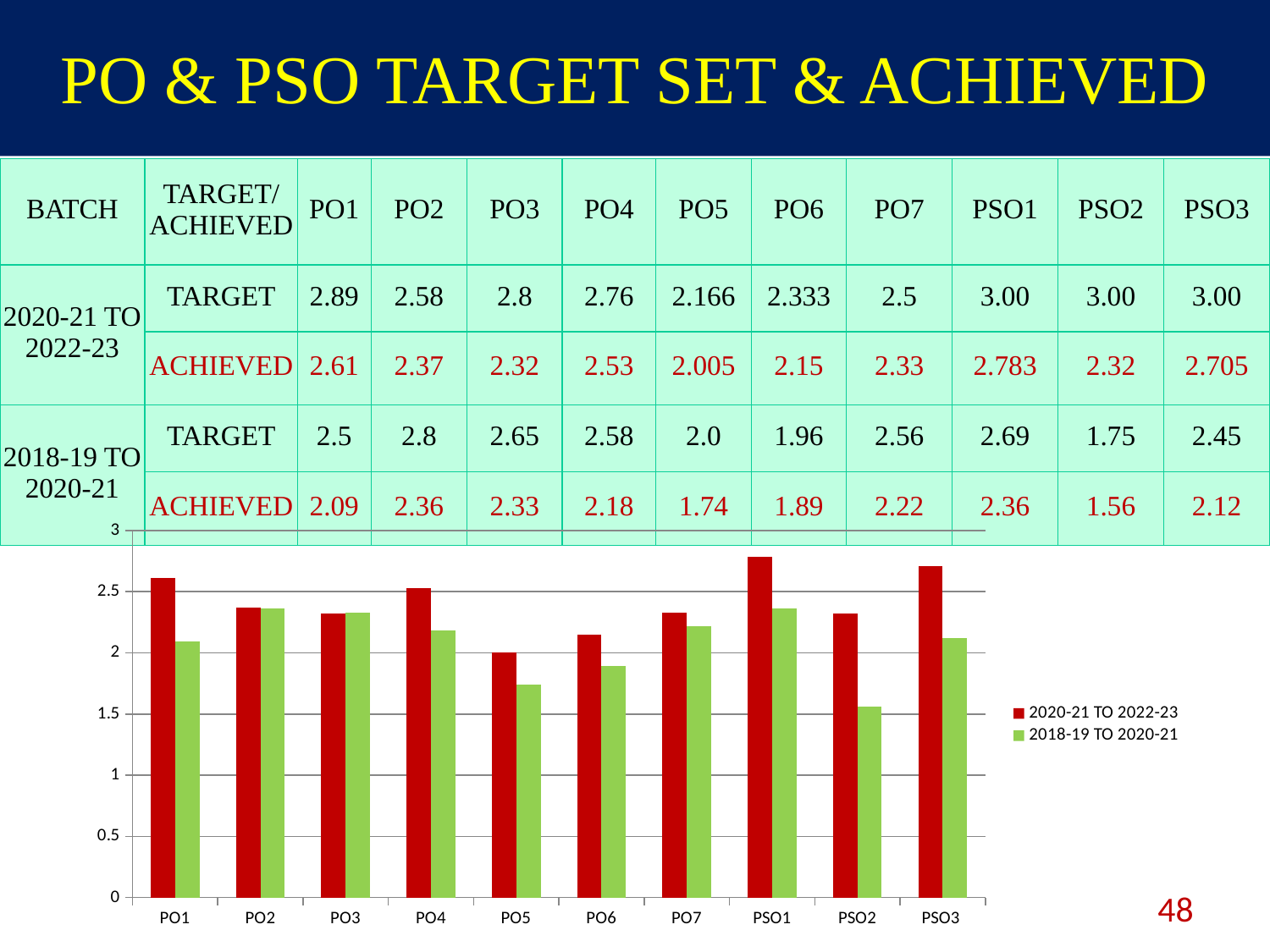
How many series does the chart's legend list? 2 In the chart, is the 2020-21 TO 2022-23 value for PSO1 greater or less than 2.5? greater In the chart, which category has the lowest bar for the 2020-21 TO 2022-23 series? PO5 What kind of chart is shown at the bottom of the slide? bar chart In the chart, is the 2018-19 TO 2020-21 value for PO5 greater or less than 2? less How many categories are shown on the x axis of the chart? 10 In the chart, for PSO2, which series has the larger bar: 2020-21 TO 2022-23 or 2018-19 TO 2020-21? 2020-21 TO 2022-23 Which series is shown in red in the chart? 2020-21 TO 2022-23 In the chart, which category has the lowest bar for the 2018-19 TO 2020-21 series? PSO2 In the chart, which category has the highest bar for the 2020-21 TO 2022-23 series? PSO1 Which series is shown in green in the chart? 2018-19 TO 2020-21 In the chart, is the 2018-19 TO 2020-21 value for PO6 greater or less than 2? less